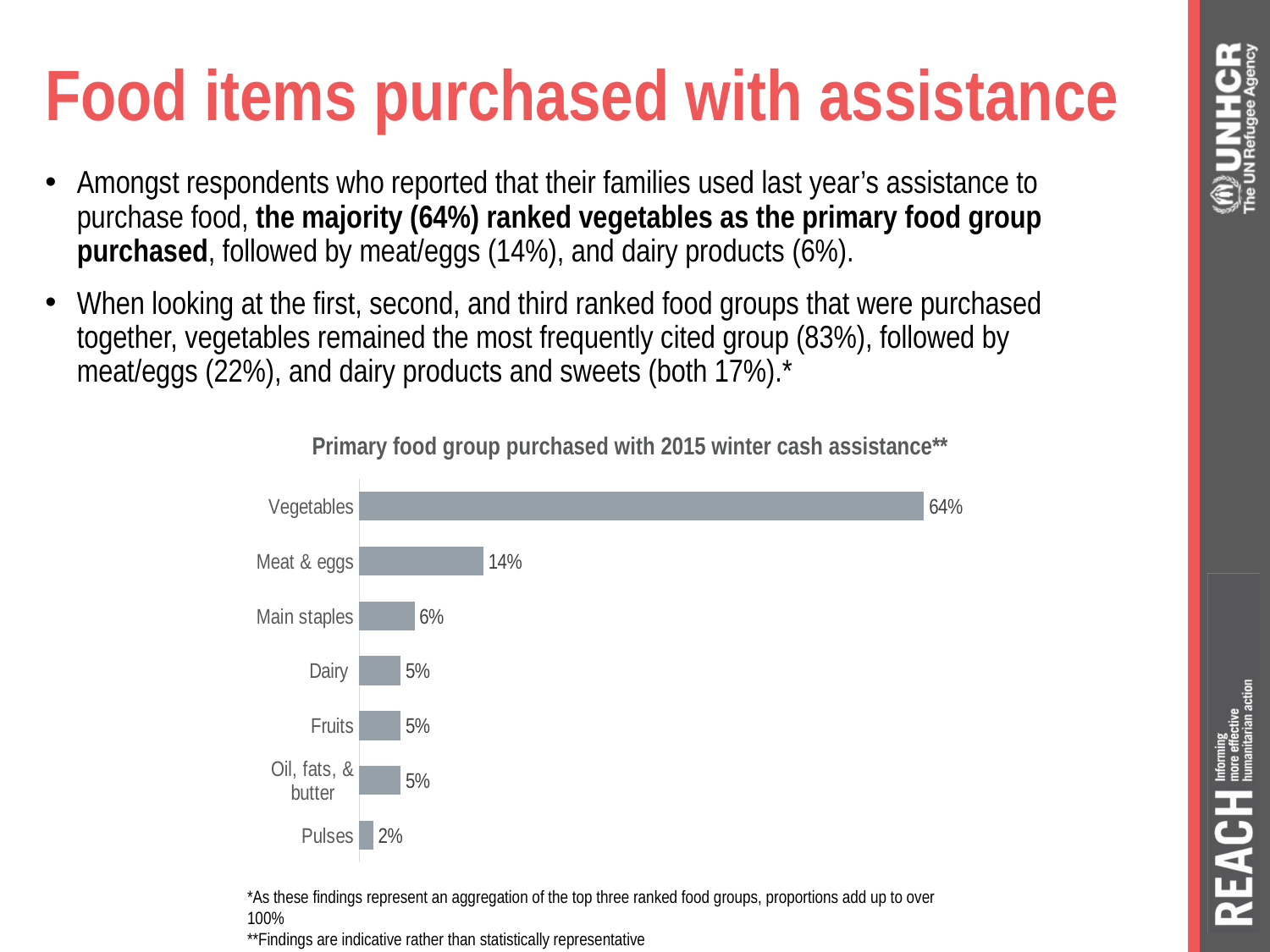
Which is larger, the value for Meat & eggs or the value for Main staples? Meat & eggs What is the title of the chart? Primary food group purchased with 2015 winter cash assistance** What is the difference between the values for Main staples and Pulses? 4% What kind of chart is shown on the slide? Bar chart What is the value for Main staples in the chart? 6% What is the difference between the values for Vegetables and Meat & eggs? 50% What is the value for Pulses in the chart? 2% What is the value for Meat & eggs in the chart? 14% How many food groups are shown in the chart? 7 Which food group has the lowest value in the chart? Pulses What is the value for Vegetables in the chart? 64% Which food group has the highest value in the chart? Vegetables